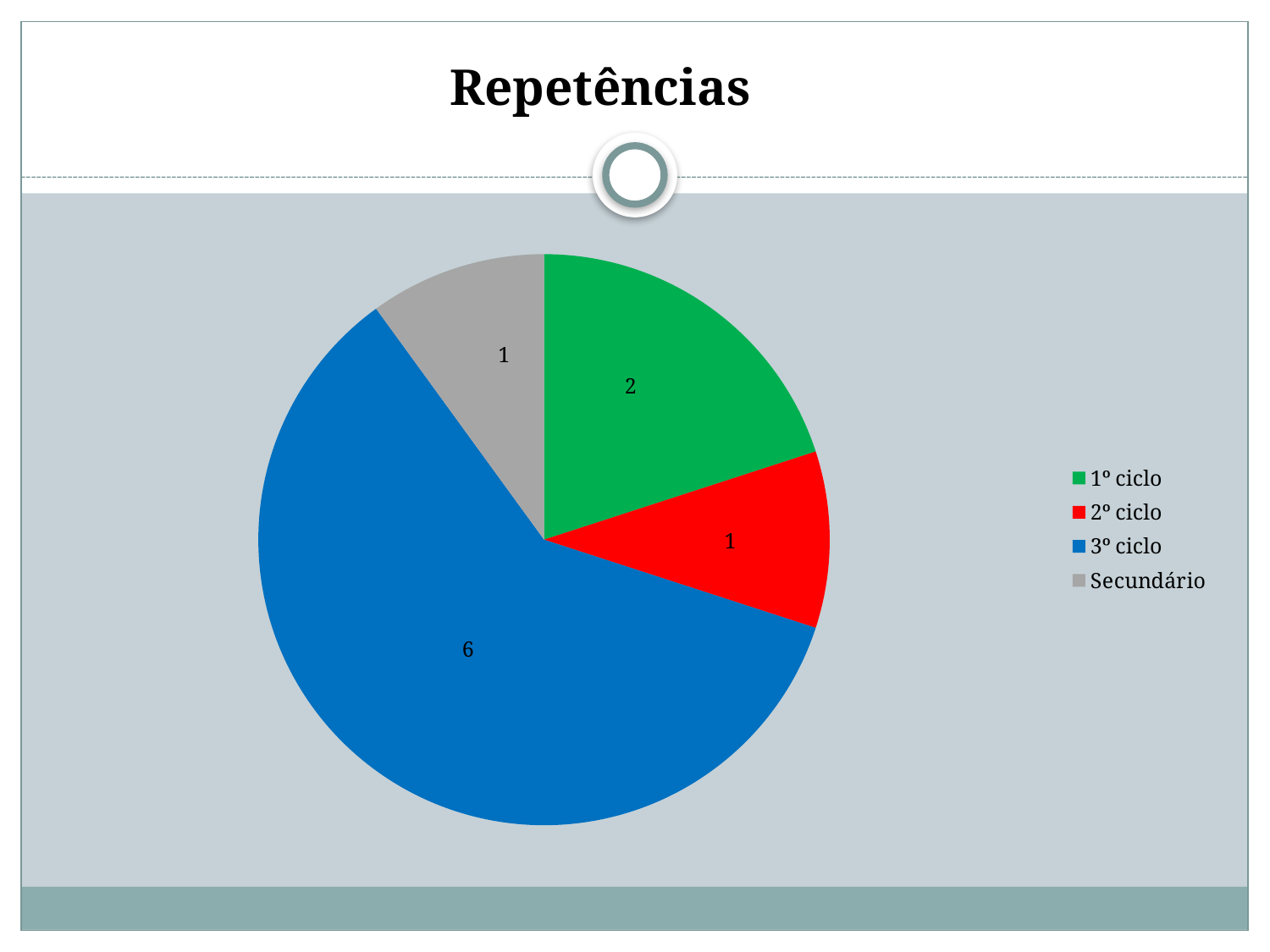
Which is larger, the value for 1º ciclo or the value for 2º ciclo? 1º ciclo Which category has the largest slice? 3º ciclo What is the difference between the values for 3º ciclo and 1º ciclo? 4 What is the title of the slide? Repetências What is the value for 1º ciclo? 2 What share of the pie does 3º ciclo represent? 60% What is the value for Secundário? 1 What is the value for 2º ciclo? 1 What is the total of all slices in the pie? 10 What type of chart is shown on the slide? pie chart How many categories does the legend list? 4 What is the value for 3º ciclo? 6